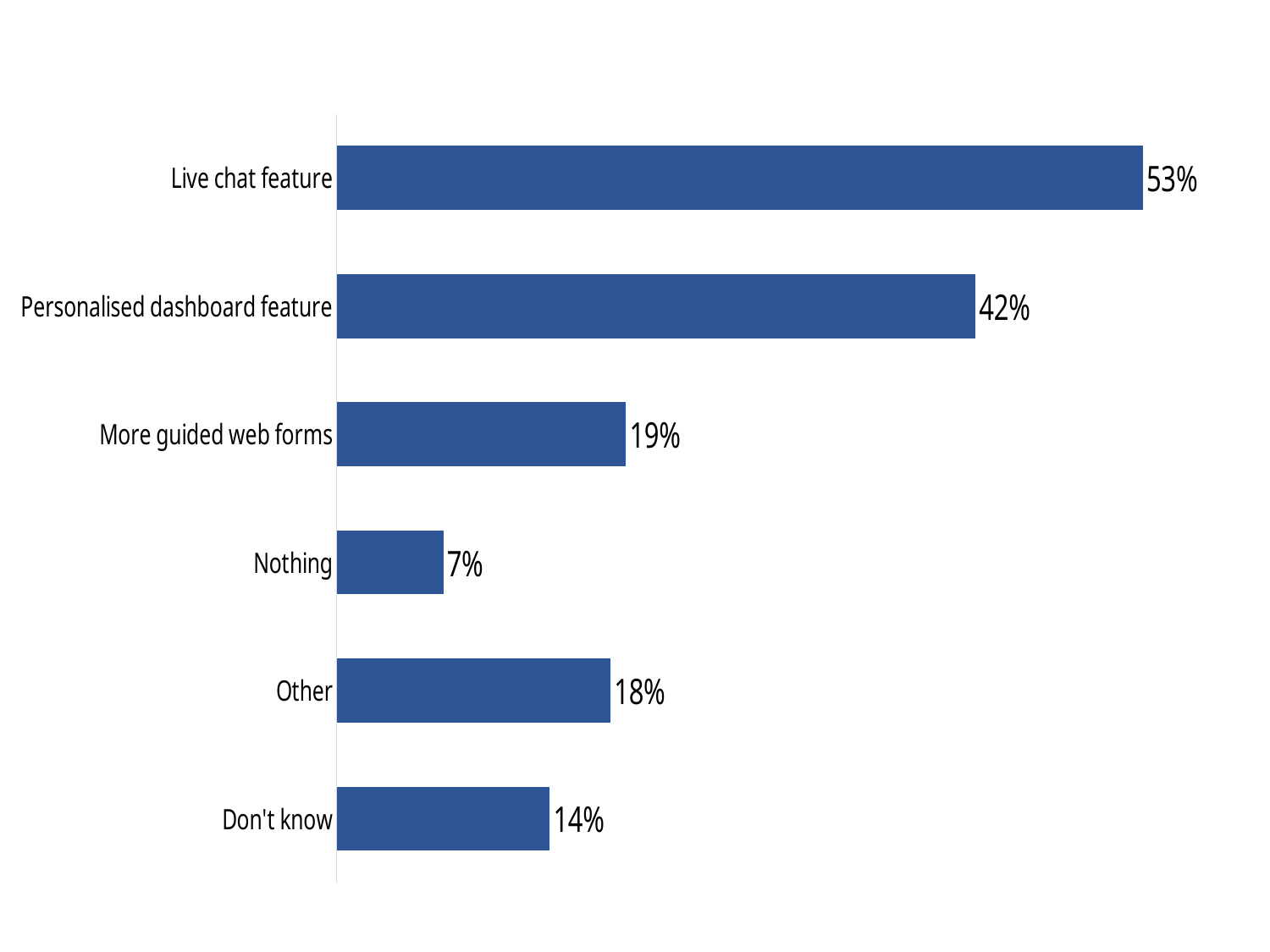
What kind of chart is this? Bar chart How many categories are shown in the chart? 6 What is the value for Don't know? 14% Which category has the highest value? Live chat feature What is the difference between the values for Live chat feature and Personalised dashboard feature? 11% Which is larger, the value for More guided web forms or the value for Other? More guided web forms What is the value for Nothing? 7% Which category has the lowest value? Nothing What is the value for Personalised dashboard feature? 42% What is the value for More guided web forms? 19% What is the difference between the values for Other and Don't know? 4% What is the value for Live chat feature? 53%